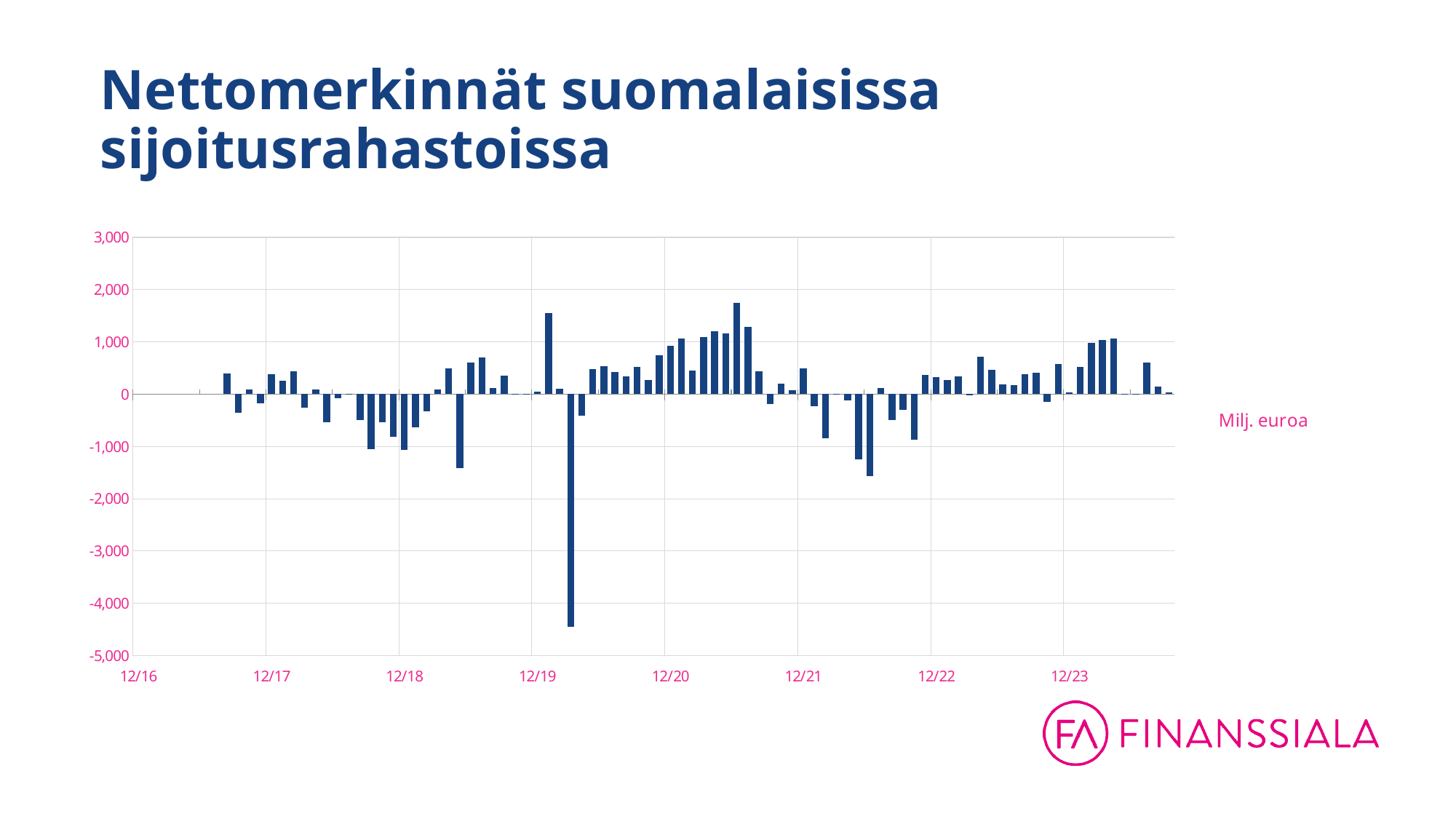
Is the value of the tallest positive bar in the chart greater or less than 2,000? less What is the lowest value shown on the y axis? -5,000 What is the highest value shown on the y axis? 3,000 Which is larger in absolute size: the tallest positive bar or the lowest negative bar? the lowest negative bar How many date labels are shown on the x axis? 8 Between which two x-axis labels does the lowest bar in the chart occur? 12/19 and 12/20 Is the value of the lowest bar in the chart greater or less than -4,000? less Is the value of the tallest positive bar in the chart greater or less than 1,000? greater What is the title of the chart? Nettomerkinnät suomalaisissa sijoitusrahastoissa What unit is indicated next to the chart? Milj. euroa What kind of chart is shown on the slide? bar chart